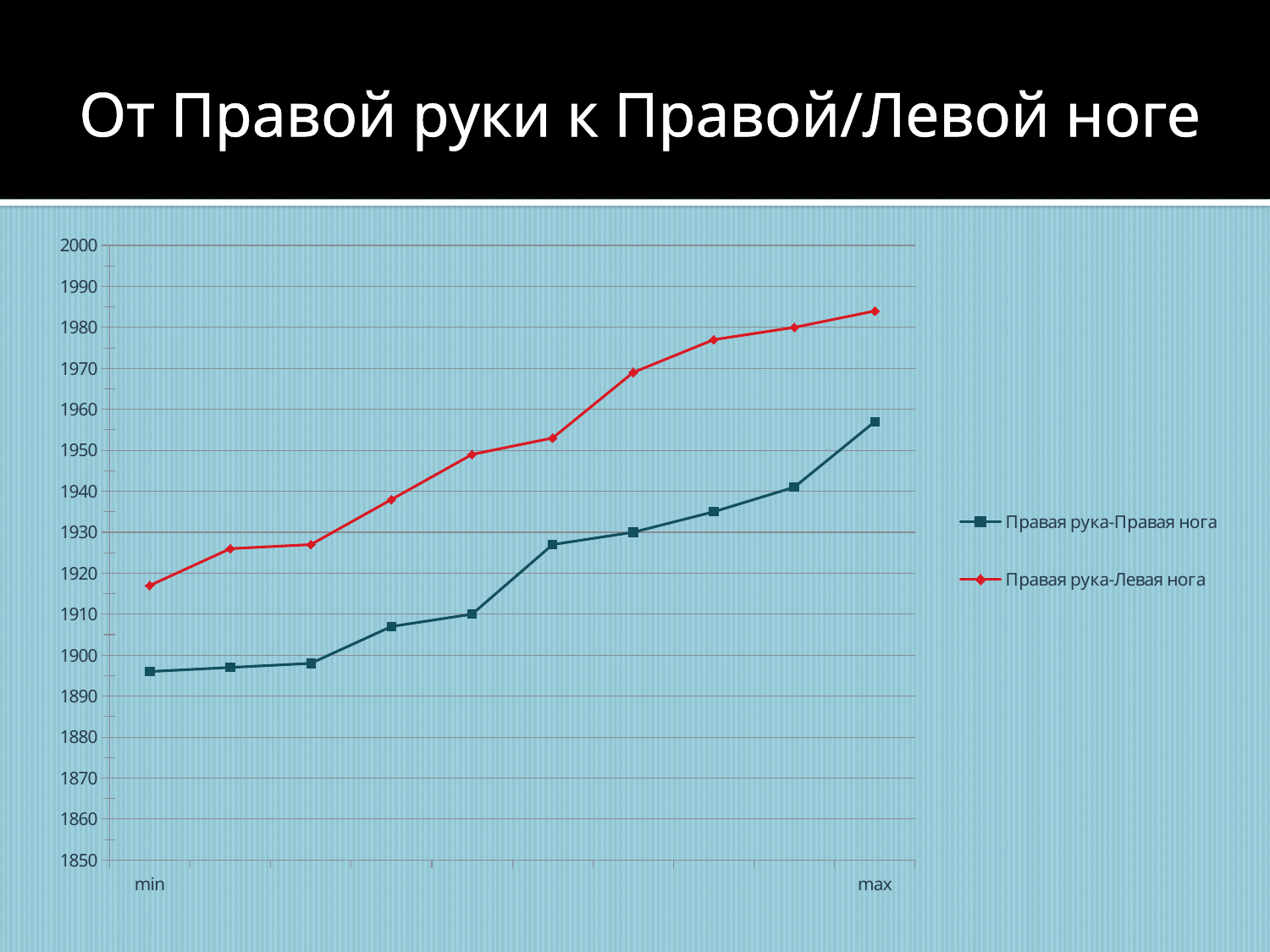
Is the value of "Правая рука-Правая нога" at "max" greater or less than 1950? greater Which series has the higher value at the "max" point, "Правая рука-Правая нога" or "Правая рука-Левая нога"? Правая рука-Левая нога Is the value of "Правая рука-Правая нога" at "min" greater or less than 1900? less Is the value of "Правая рука-Левая нога" at "max" greater or less than 1970? greater Do the values of "Правая рука-Правая нога" rise or fall from "min" to "max"? rise What kind of chart is shown on the slide? line chart How many series does the legend list? 2 What is the title of the slide containing the chart? От Правой руки к Правой/Левой ноге What colour is the line for "Правая рука-Левая нога"? red Which series lies higher across the whole chart? Правая рука-Левая нога How many data points does the "Правая рука-Левая нога" series have? 10